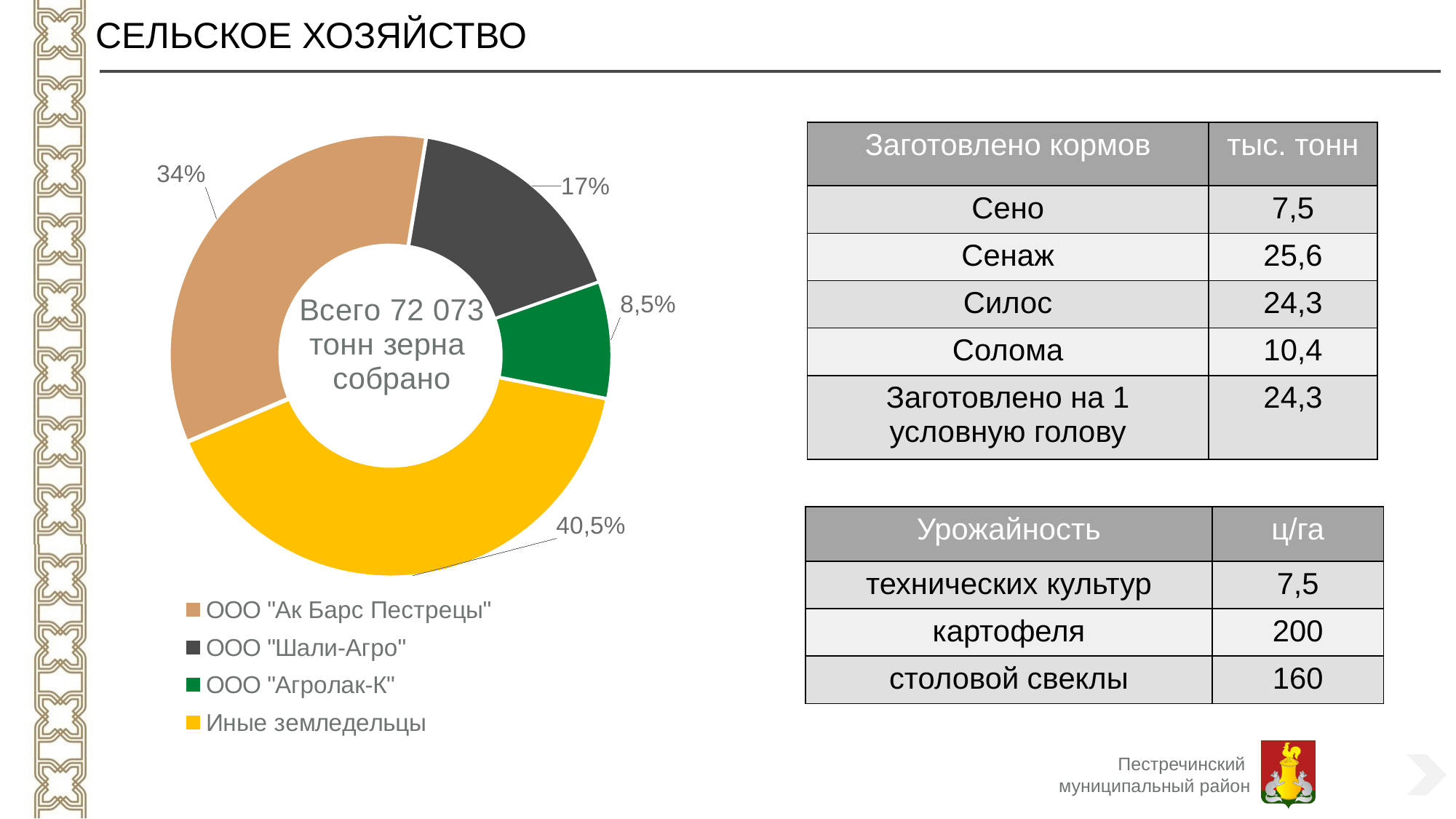
Which has a larger share: ООО "Шали-Агро" or ООО "Агролак-К"? ООО "Шали-Агро" What share of the grain harvest does ООО "Агролак-К" account for? 8,5% How many categories does the doughnut chart show? 4 What total amount of grain harvested is stated in the centre of the chart? 72 073 тонн What share of the grain harvest does ООО "Шали-Агро" account for? 17% What share of the grain harvest does ООО "Ак Барс Пестрецы" account for? 34% What share of the grain harvest do Иные земледельцы account for? 40,5% What kind of chart is shown on the slide? Doughnut (pie) chart Which category has the largest share of the grain harvest? Иные земледельцы Which category has the smallest share of the grain harvest? ООО "Агролак-К" What is the difference in percentage points between the shares of Иные земледельцы and ООО "Ак Барс Пестрецы"? 6,5 Which colour represents Иные земледельцы in the chart? Yellow